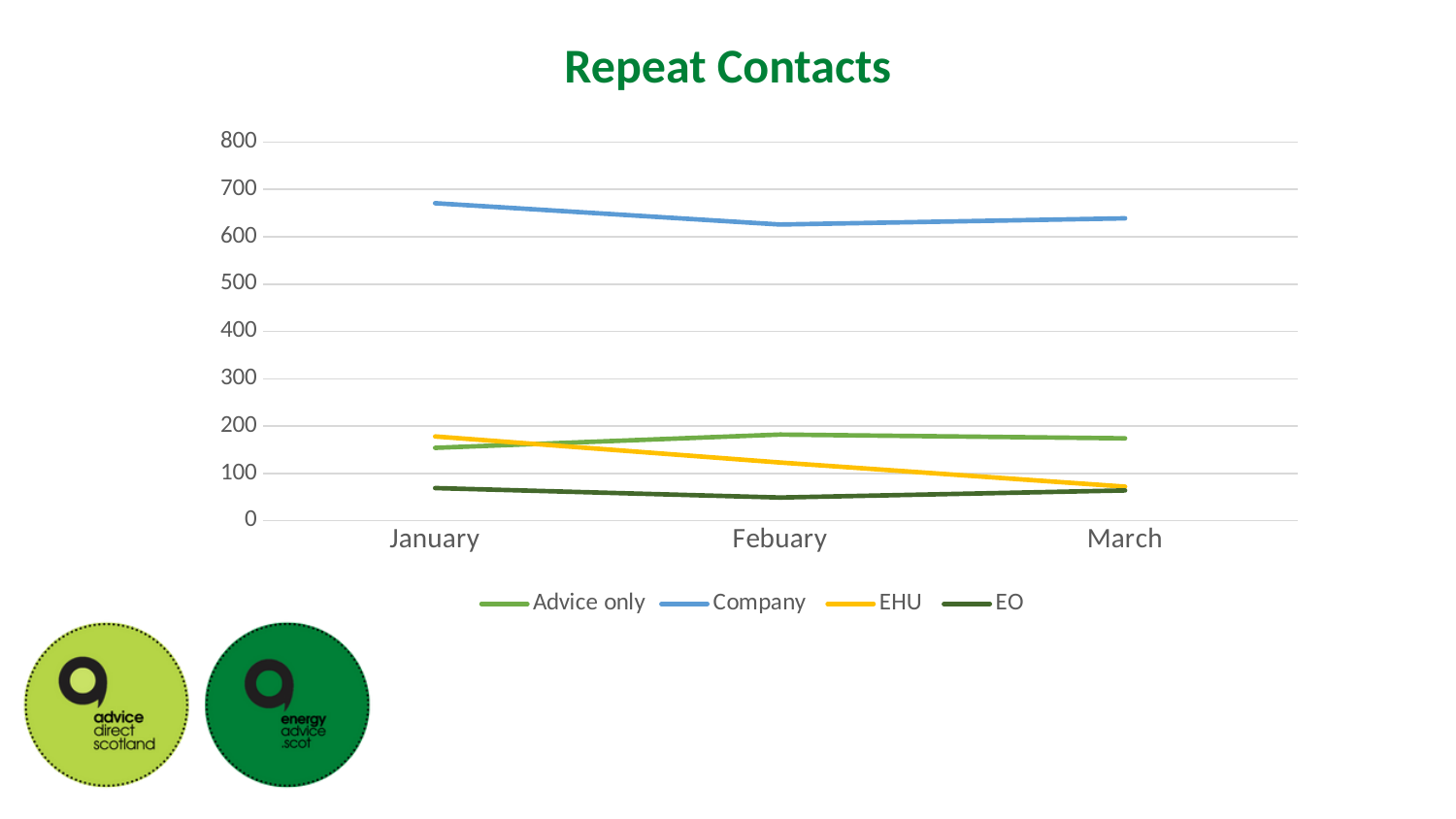
What kind of chart is shown on the slide? line chart Is the value for Company in January greater or less than 600? greater In which month is the EHU value highest? January Which series has the highest value in February? Company What is the title of the chart? Repeat Contacts How many months are shown on the x axis? 3 Is the value for Advice only in February greater or less than 200? less Which is larger in March, Advice only or EHU? Advice only Is the value for EHU in March greater or less than 100? less Which series has the lowest value in February? EO How many series does the legend list? 4 Does the EHU line rise or fall from January to March? fall